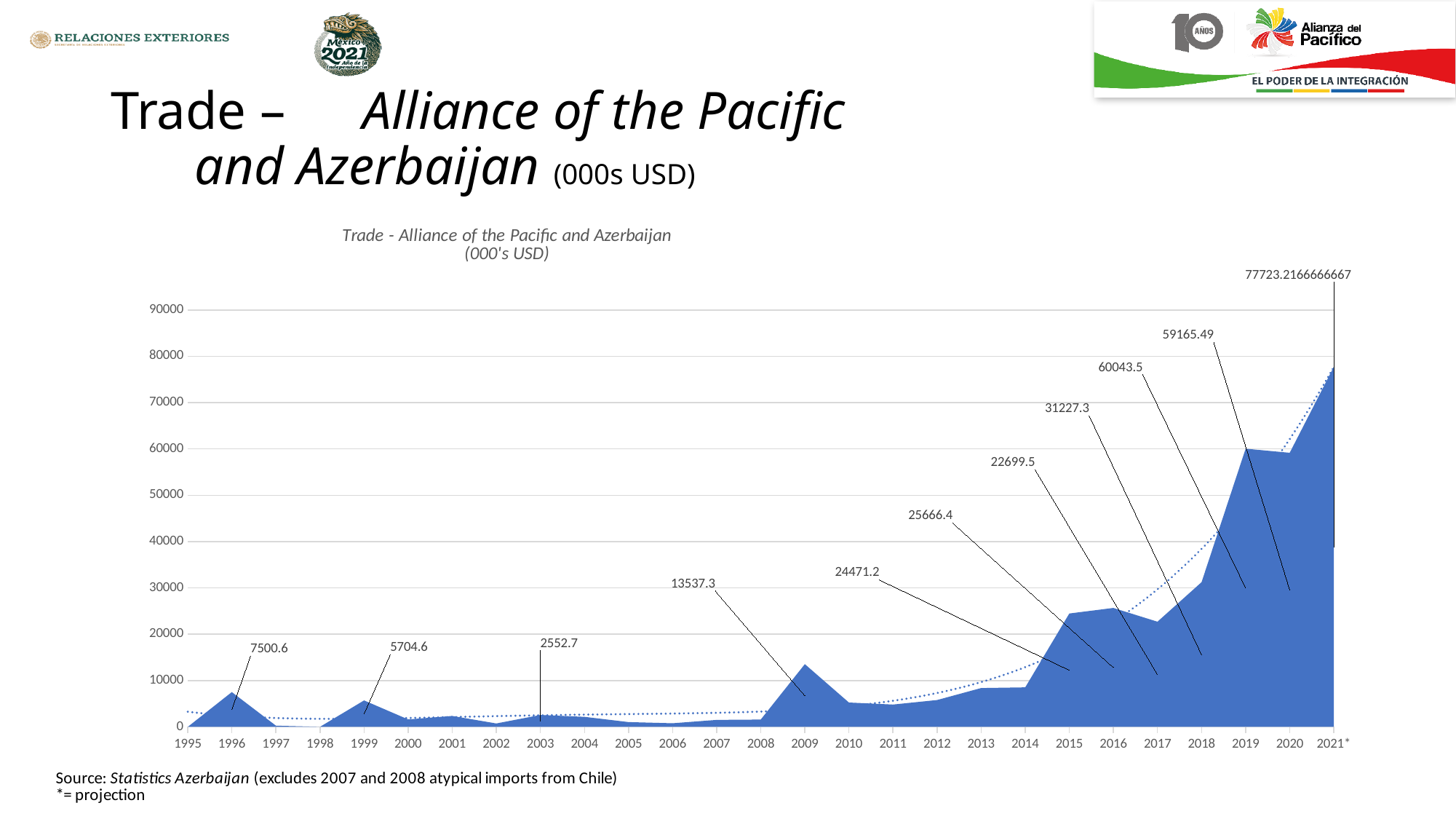
How many years are shown on the x axis of the chart? 27 Which is larger, the trade value for 2019 or for 2020? 2019 What is the trade value for 2019? 60043.5 Is the trade value for 2013 greater or less than 10000? less What is the trade value for 2021* in the chart? 77723.2166666667 What is the trade value for 2009? 13537.3 What does the asterisk on 2021* indicate according to the slide? Projection What is the difference between the trade values for 2016 and 2015? 1195.2 Does the trade value generally rise or fall from 2014 to 2021*? Rise What type of chart is shown on the slide? Area chart Which year has the highest trade value in the chart? 2021* What is the trade value for 1996? 7500.6